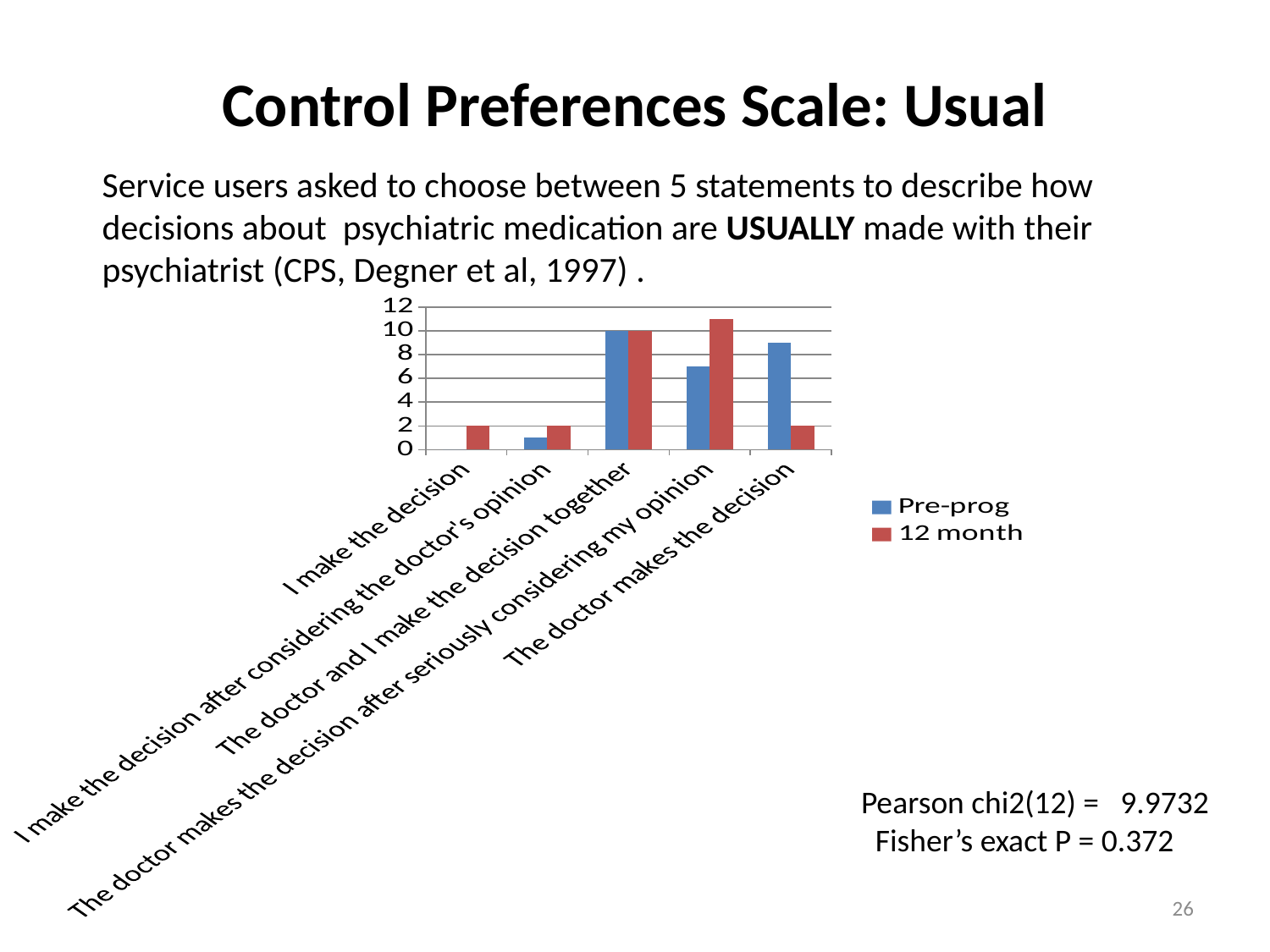
What is the 12 month value for "The doctor and I make the decision together"? 10 Which category has the highest 12 month value? The doctor makes the decision after seriously considering my opinion Which series is shown in red in the legend? 12 month What is the Pre-prog value for "The doctor and I make the decision together"? 10 How many categories are shown on the x axis? 5 What is the 12 month value for "I make the decision"? 2 What is the 12 month value for "The doctor makes the decision"? 2 How many series does the legend list? 2 Is the 12 month value for "The doctor makes the decision after seriously considering my opinion" greater or less than 10? greater Is the Pre-prog value for "The doctor makes the decision" greater or less than 8? greater For "The doctor makes the decision", which series has the larger value, Pre-prog or 12 month? Pre-prog What kind of chart is shown on the slide? bar chart